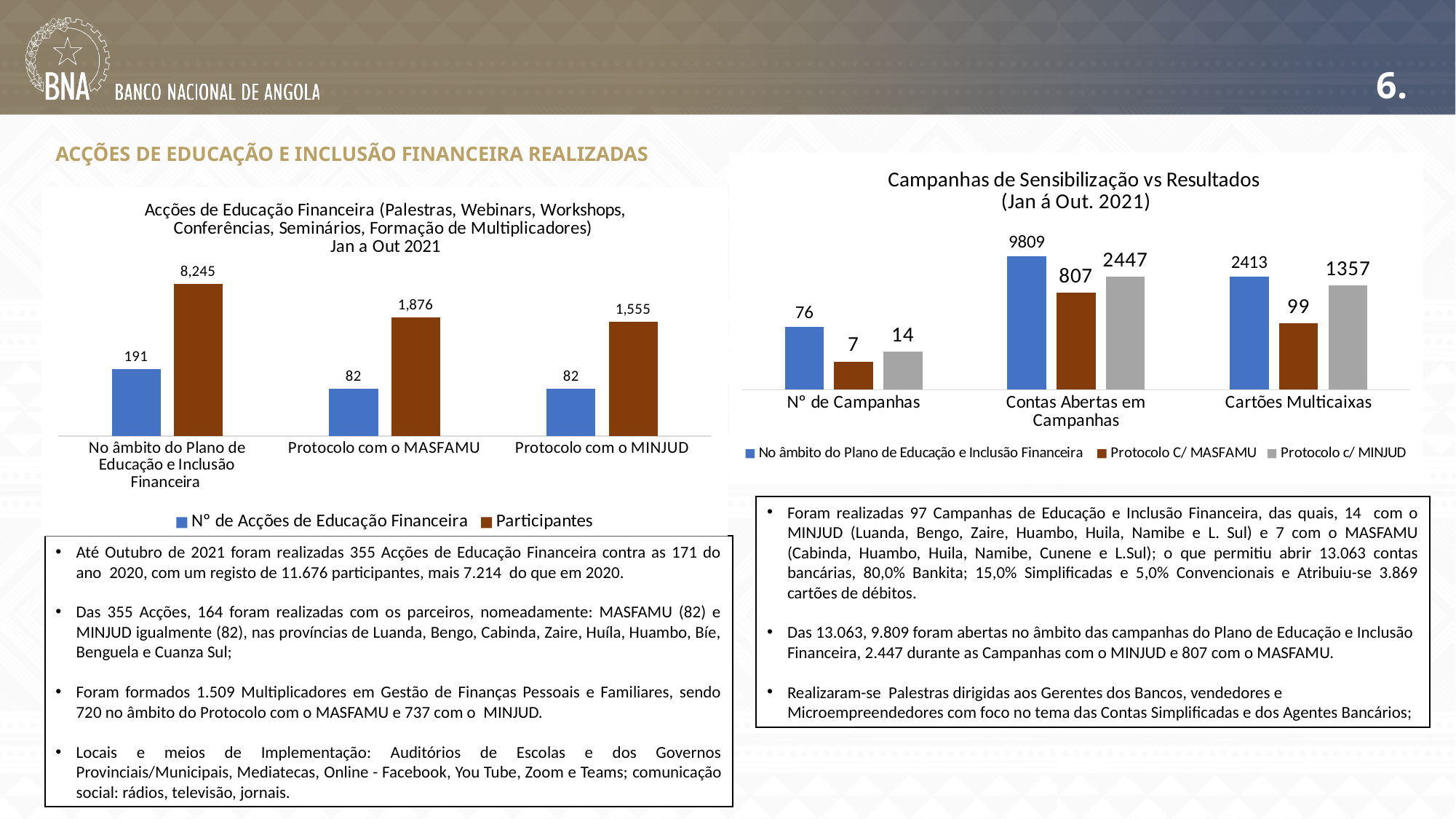
In the right chart (Campanhas de Sensibilização vs Resultados), which is larger for 'Cartões Multicaixas': 'No âmbito do Plano de Educação e Inclusão Financeira' or 'Protocolo c/ MINJUD'? No âmbito do Plano de Educação e Inclusão Financeira In the right chart (Campanhas de Sensibilização vs Resultados), what is the value of 'Cartões Multicaixas' for 'Protocolo C/ MASFAMU'? 99 In the left chart (Acções de Educação Financeira, Jan a Out 2021), what is the Nº de Acções de Educação Financeira for 'Protocolo com o MASFAMU'? 82 How many categories are shown on the x axis of the right chart (Campanhas de Sensibilização vs Resultados)? 3 In the left chart (Acções de Educação Financeira, Jan a Out 2021), what is the difference in Participantes between 'Protocolo com o MASFAMU' and 'Protocolo com o MINJUD'? 321 What type of chart is the left chart (Acções de Educação Financeira, Jan a Out 2021)? Bar chart In the left chart (Acções de Educação Financeira, Jan a Out 2021), how many series does the legend list? 2 In the right chart (Campanhas de Sensibilização vs Resultados), which series has the lowest value for 'Nº de Campanhas'? Protocolo C/ MASFAMU In the left chart (Acções de Educação Financeira, Jan a Out 2021), how many Participantes are shown for 'No âmbito do Plano de Educação e Inclusão Financeira'? 8,245 In the right chart (Campanhas de Sensibilização vs Resultados), what is the difference between 'Contas Abertas em Campanhas' for 'No âmbito do Plano de Educação e Inclusão Financeira' and for 'Protocolo C/ MASFAMU'? 9002 In the right chart (Campanhas de Sensibilização vs Resultados), what is the value of 'Contas Abertas em Campanhas' for 'Protocolo c/ MINJUD'? 2447 In the left chart (Acções de Educação Financeira, Jan a Out 2021), which category has the highest number of Participantes? No âmbito do Plano de Educação e Inclusão Financeira